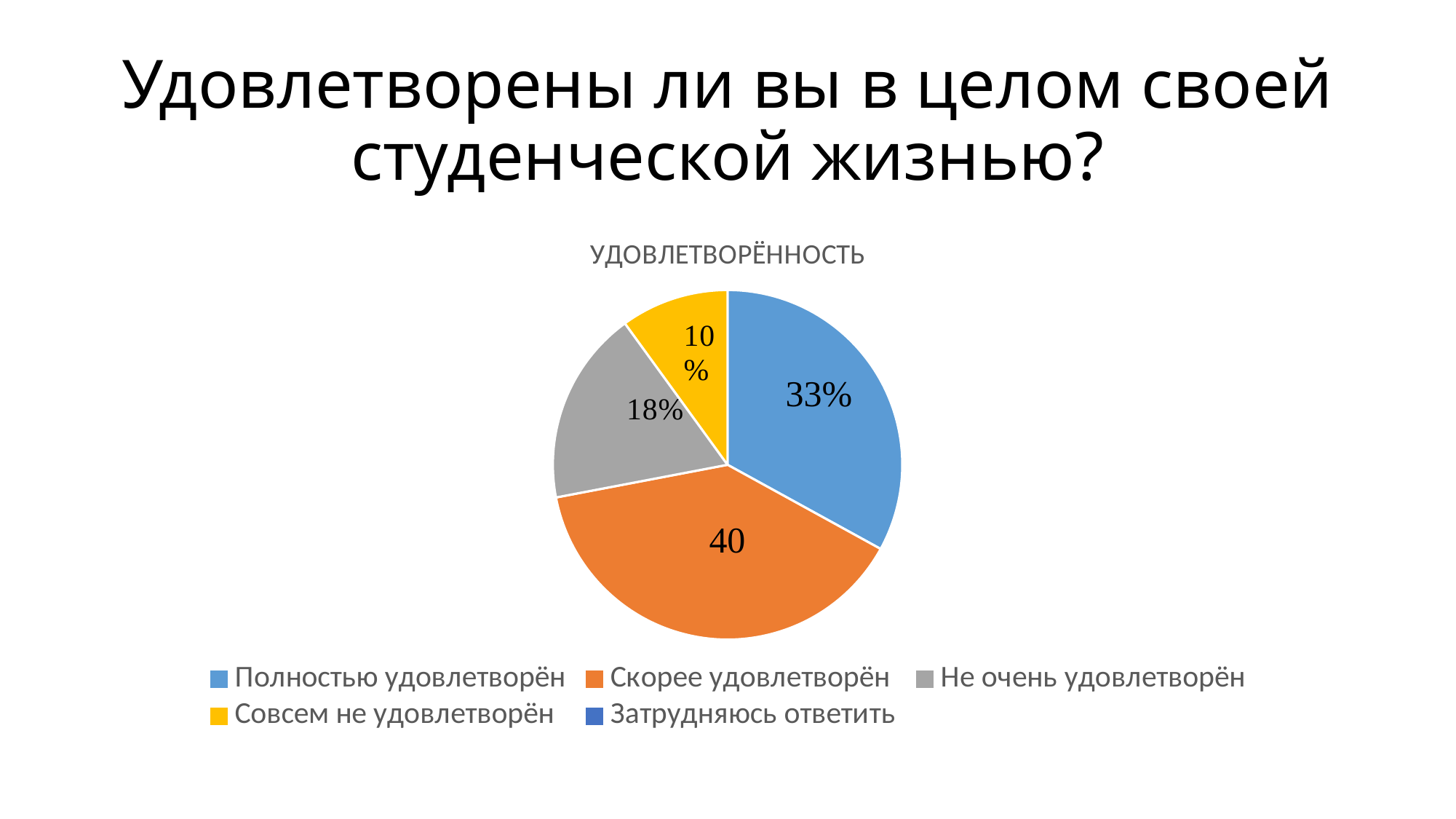
Which category has the largest slice of the pie? Скорее удовлетворён By how many percentage points does "Не очень удовлетворён" exceed "Совсем не удовлетворён"? 8% What is the title of the pie chart? УДОВЛЕТВОРЁННОСТЬ Which of the visible slices is the smallest? Совсем не удовлетворён Which slice is larger: "Полностью удовлетворён" or "Не очень удовлетворён"? Полностью удовлетворён What value is printed on the "Скорее удовлетворён" slice? 40 What share of the pie is labelled for "Совсем не удовлетворён"? 10% What share of the pie is labelled for "Не очень удовлетворён"? 18% What kind of chart is shown on the slide? pie chart What share of the pie is labelled for "Полностью удовлетворён"? 33% How many entries does the chart legend list? 5 How many slices are visible in the pie chart? 4